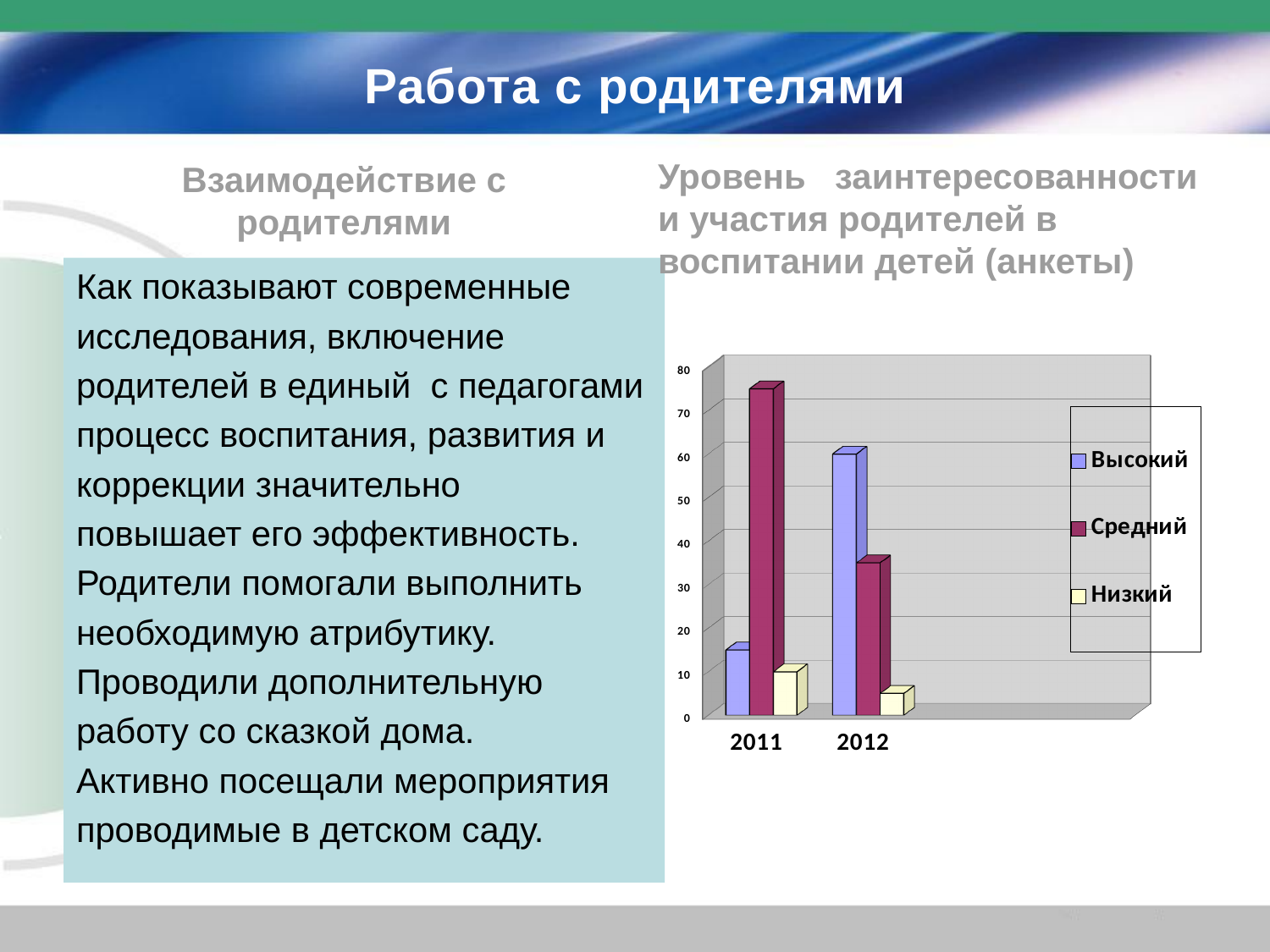
Is the value for Низкий in 2012 greater or less than 10? less Which series has the highest value in 2012? Высокий Is the value for Высокий in 2012 greater or less than 50? greater Which is larger: the value for Средний in 2011 or in 2012? 2011 Is the value for Средний in 2011 greater or less than 60? greater What kind of chart is shown on the slide? bar chart How many categories (years) are shown on the x axis of the chart? 2 How many series does the chart legend list? 3 Which series has the highest value in 2011? Средний Which series has the lowest value in 2011? Низкий Does the value for Высокий rise or fall from 2011 to 2012? rise